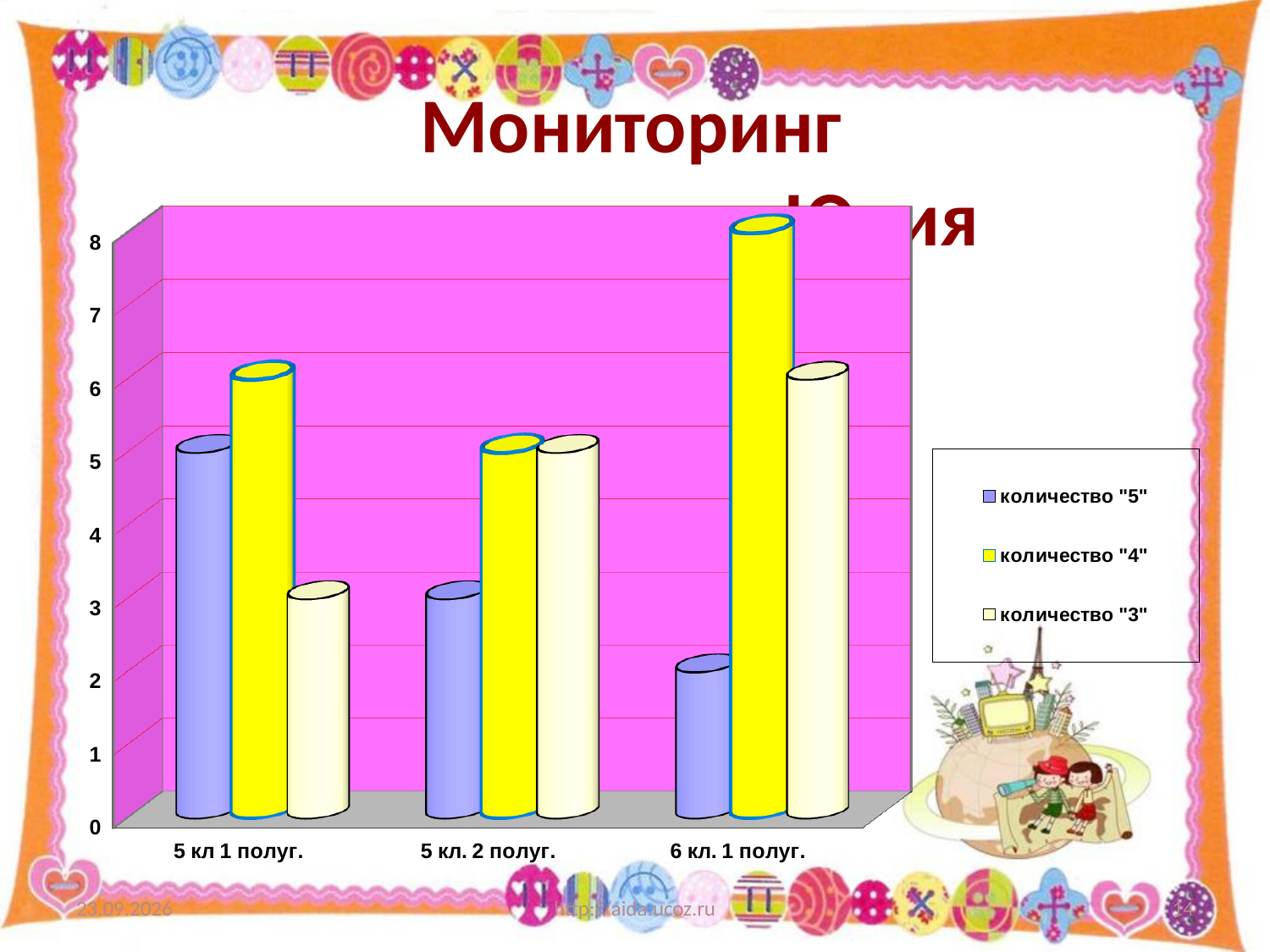
What are the three series listed in the chart's legend? количество "5", количество "4", количество "3" How many categories are shown on the x axis of the chart? 3 Which category has the highest value of количество "4"? 6 кл. 1 полуг. Is the value of количество "4" for 6 кл. 1 полуг. greater or less than 7? greater How many series does the chart's legend list? 3 Is the value of количество "5" for 6 кл. 1 полуг. greater or less than 3? less Which series has the highest value in 6 кл. 1 полуг.? количество "4" What kind of chart is shown on the slide? bar chart Which category has the lowest value of количество "5"? 6 кл. 1 полуг. In 5 кл 1 полуг., which is larger: количество "5" or количество "3"? количество "5" Does the value of количество "5" rise or fall from 5 кл 1 полуг. to 6 кл. 1 полуг.? fall Is the value of количество "3" for 5 кл 1 полуг. greater or less than 4? less